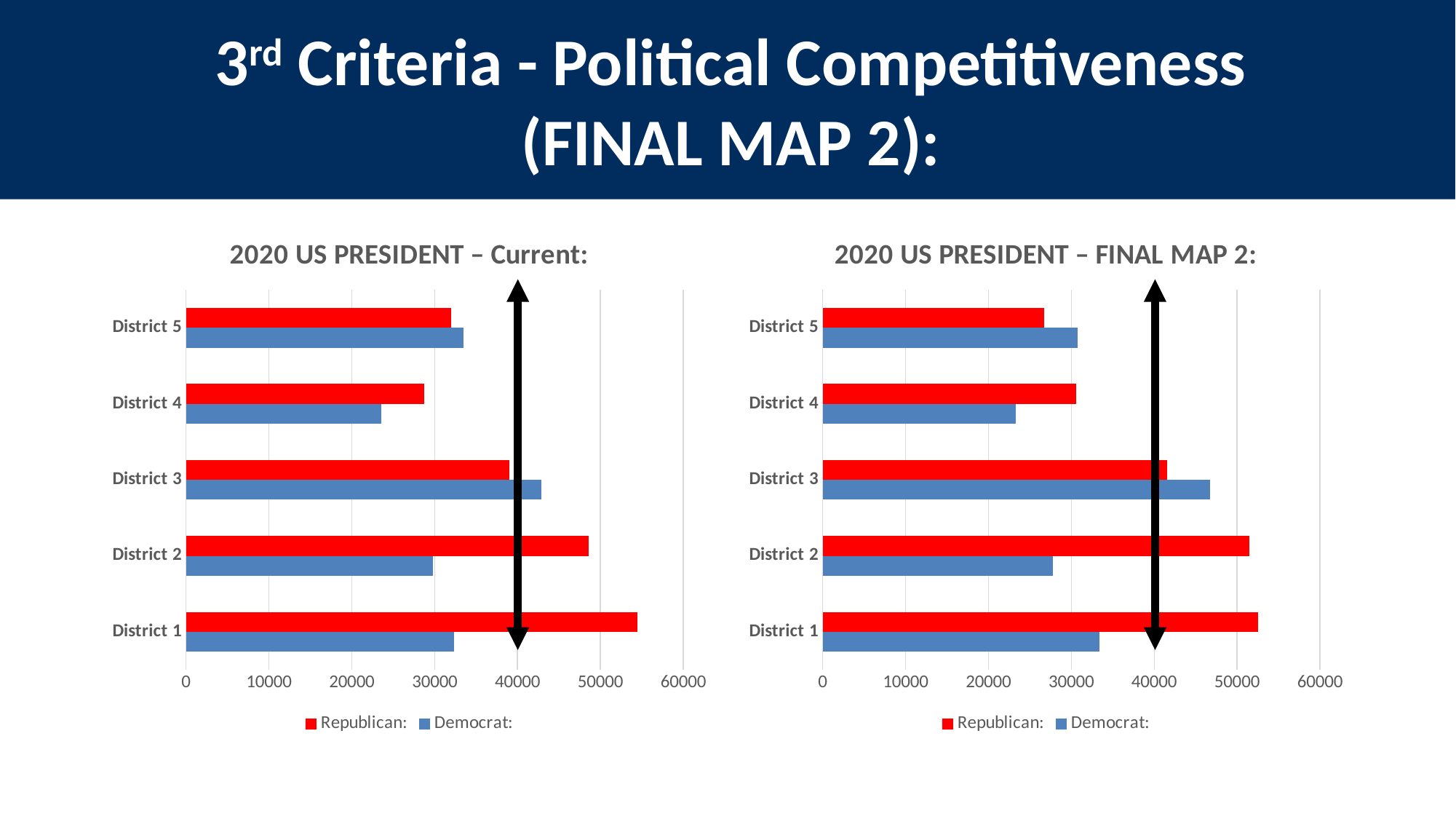
In the "2020 US PRESIDENT – Current:" chart, which district has the lowest Democrat value? District 4 In the "2020 US PRESIDENT – Current:" chart, which district has the highest Republican value? District 1 In the "2020 US PRESIDENT – Current:" chart, is the Republican value for District 1 greater or less than 50000? greater How many districts are shown on the "2020 US PRESIDENT – FINAL MAP 2:" chart? 5 How many series does the legend of the "2020 US PRESIDENT – Current:" chart list? 2 What kind of chart is the "2020 US PRESIDENT – Current:" chart? Bar chart In the "2020 US PRESIDENT – FINAL MAP 2:" chart, is the Democrat value for District 3 greater or less than 40000? greater In the "2020 US PRESIDENT – FINAL MAP 2:" chart, which district has the lowest Republican value? District 5 In the "2020 US PRESIDENT – FINAL MAP 2:" chart, which district has the highest Democrat value? District 3 In the "2020 US PRESIDENT – Current:" chart, which is larger for District 3, the Republican or the Democrat value? Democrat In the "2020 US PRESIDENT – Current:" chart, is the Democrat value for District 4 greater or less than 30000? less In the "2020 US PRESIDENT – FINAL MAP 2:" chart, what colour represents the Republican series? Red